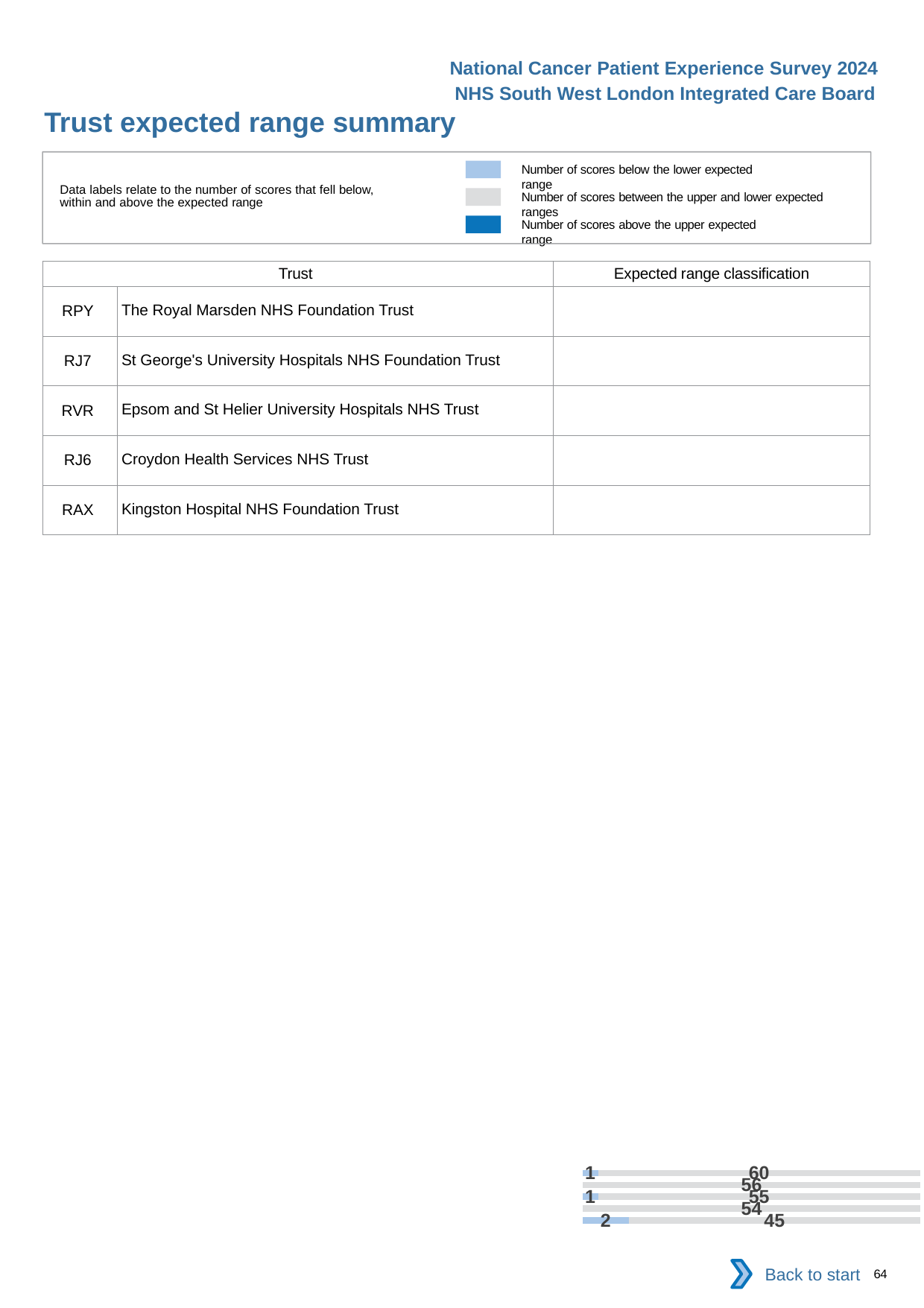
In the chart at the bottom of the slide, what is the grey value labelled on the bottom bar? 45 In the chart at the bottom of the slide, which bar has the highest grey (within expected range) value? The top bar (60) In the chart at the bottom of the slide, what is the difference between the grey value on the top bar (60) and the grey value on the bottom bar (45)? 15 In the chart at the bottom of the slide, what is the light blue (below lower expected range) value labelled on the bottom bar? 2 According to the legend, which colour represents the number of scores above the upper expected range? Dark blue How many categories does the legend at the top of the slide list? 3 In the chart at the bottom of the slide, is the grey value on the second bar (56) larger or smaller than the grey value on the fourth bar (54)? Larger In the chart at the bottom of the slide, which bar has the lowest grey (within expected range) value? The bottom bar (45) In the chart at the bottom of the slide, what is the total of the top bar (light blue 1 plus grey 60)? 61 How many bars are shown in the chart at the bottom of the slide? 5 In the chart at the bottom of the slide, what is the grey (within expected range) value labelled on the top bar? 60 What kind of chart appears at the bottom of the slide? Stacked horizontal bar chart